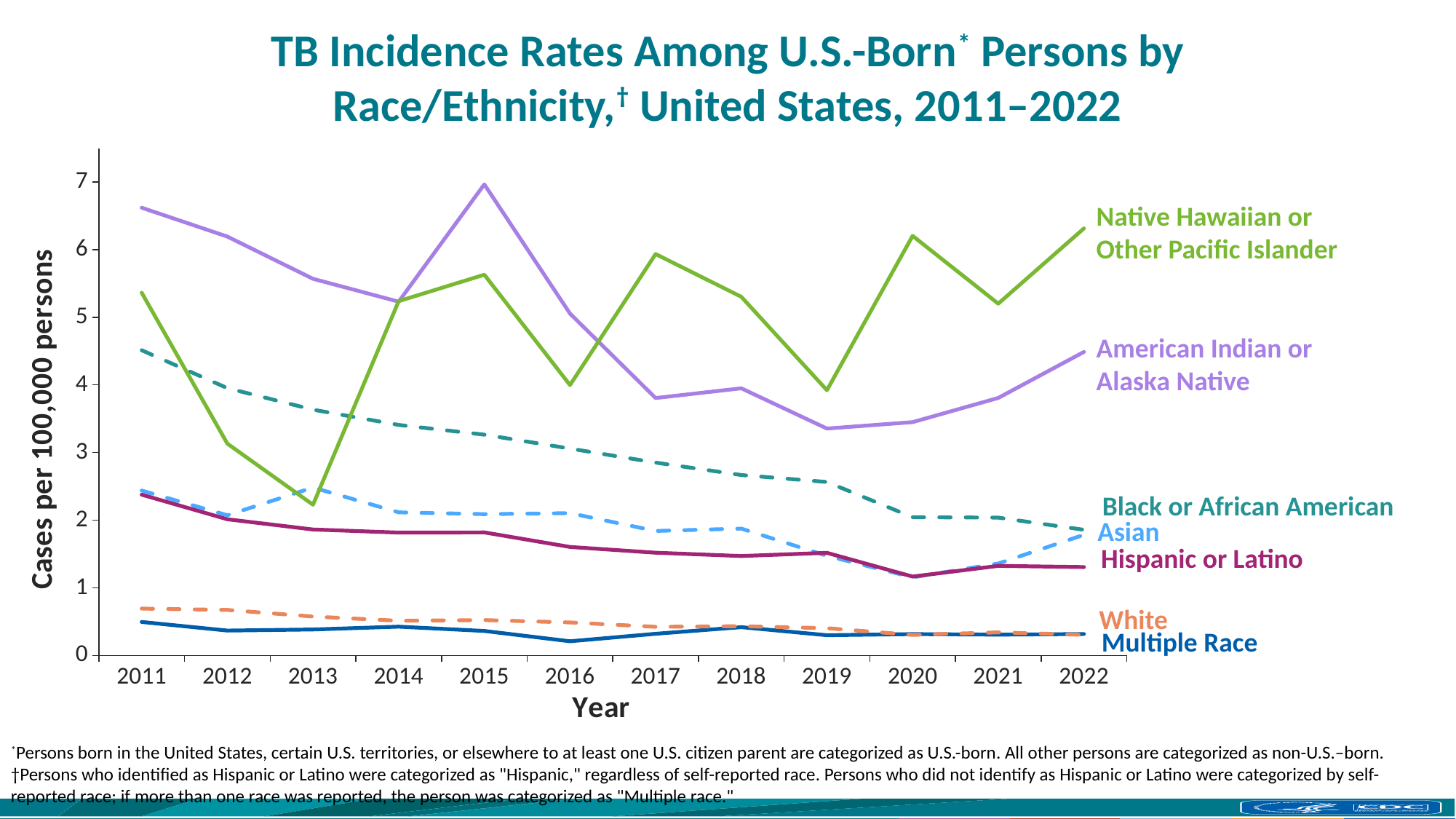
Which race/ethnicity group has the lowest TB incidence rate in 2016? Multiple Race What kind of chart is shown on the slide? Line chart Which race/ethnicity group has the highest TB incidence rate in 2022? Native Hawaiian or Other Pacific Islander Is the value for Black or African American in 2011 greater or less than 4? greater Which race/ethnicity group has the highest TB incidence rate in 2011? American Indian or Alaska Native Does the TB incidence rate for Black or African American persons generally rise or fall from 2011 to 2022? Fall Is the value for Native Hawaiian or Other Pacific Islander in 2013 greater or less than 3? less How many race/ethnicity series are plotted on the chart? 7 In 2020, which is larger: the rate for Native Hawaiian or Other Pacific Islander or the rate for American Indian or Alaska Native? Native Hawaiian or Other Pacific Islander How many years are shown along the x axis? 12 Is the value for American Indian or Alaska Native in 2015 greater or less than 6? greater What is the label on the y axis of the chart? Cases per 100,000 persons